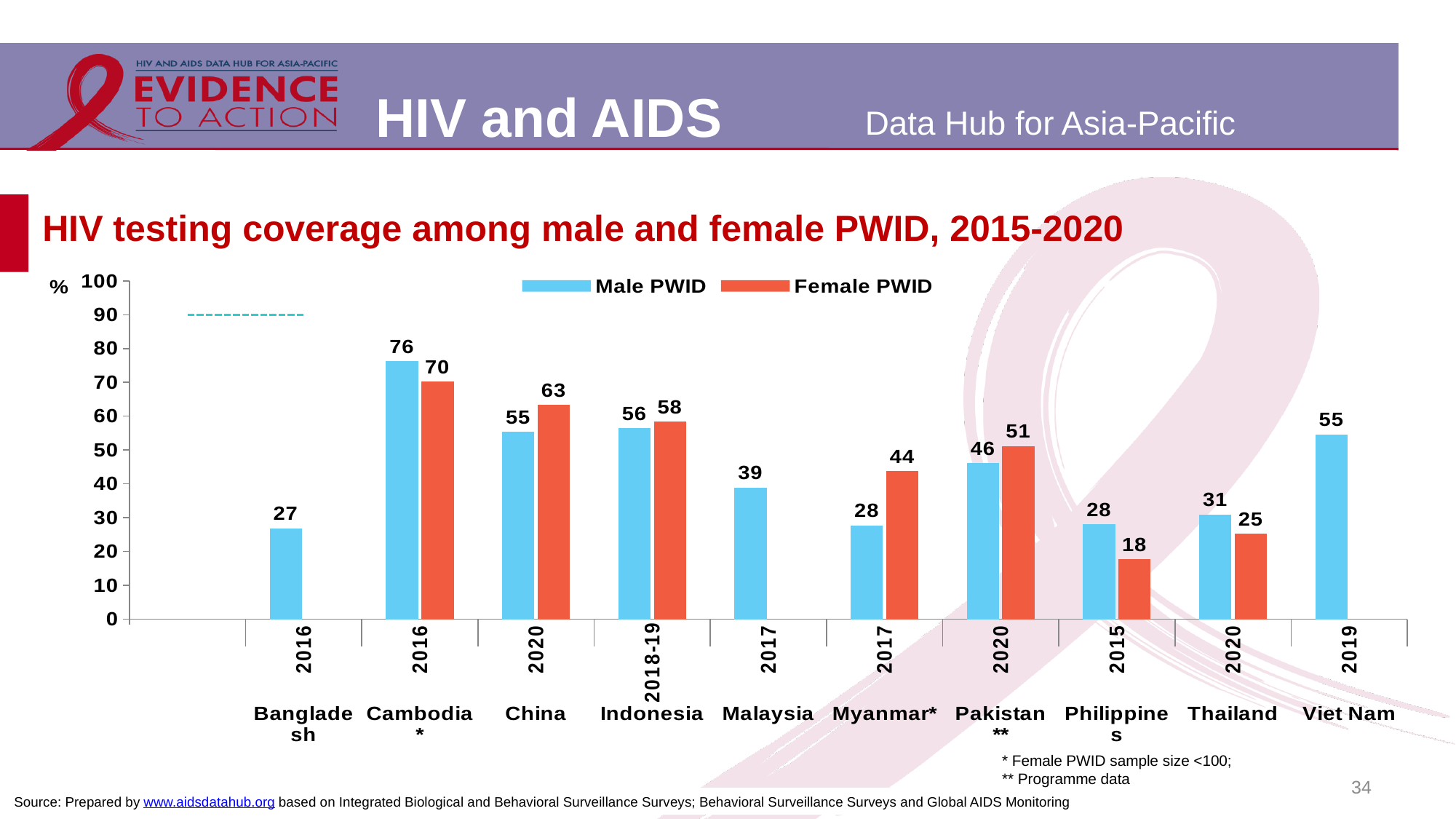
How many countries are shown on the x axis? 10 Which country has the highest Male PWID testing coverage? Cambodia What is the difference between Male PWID and Female PWID testing coverage in Thailand? 6 How many series does the legend list? 2 What is the value for Female PWID in the Philippines? 18 Which is larger in Pakistan, the Male PWID value or the Female PWID value? Female PWID What colour represents Female PWID in the chart? red/orange What is the HIV testing coverage for Female PWID in Myanmar? 44 What is the HIV testing coverage for Male PWID in Cambodia? 76 Is the Male PWID value for Malaysia greater or less than 40? less What kind of chart is shown on the slide? bar chart Which country has the lowest Female PWID testing coverage? Philippines